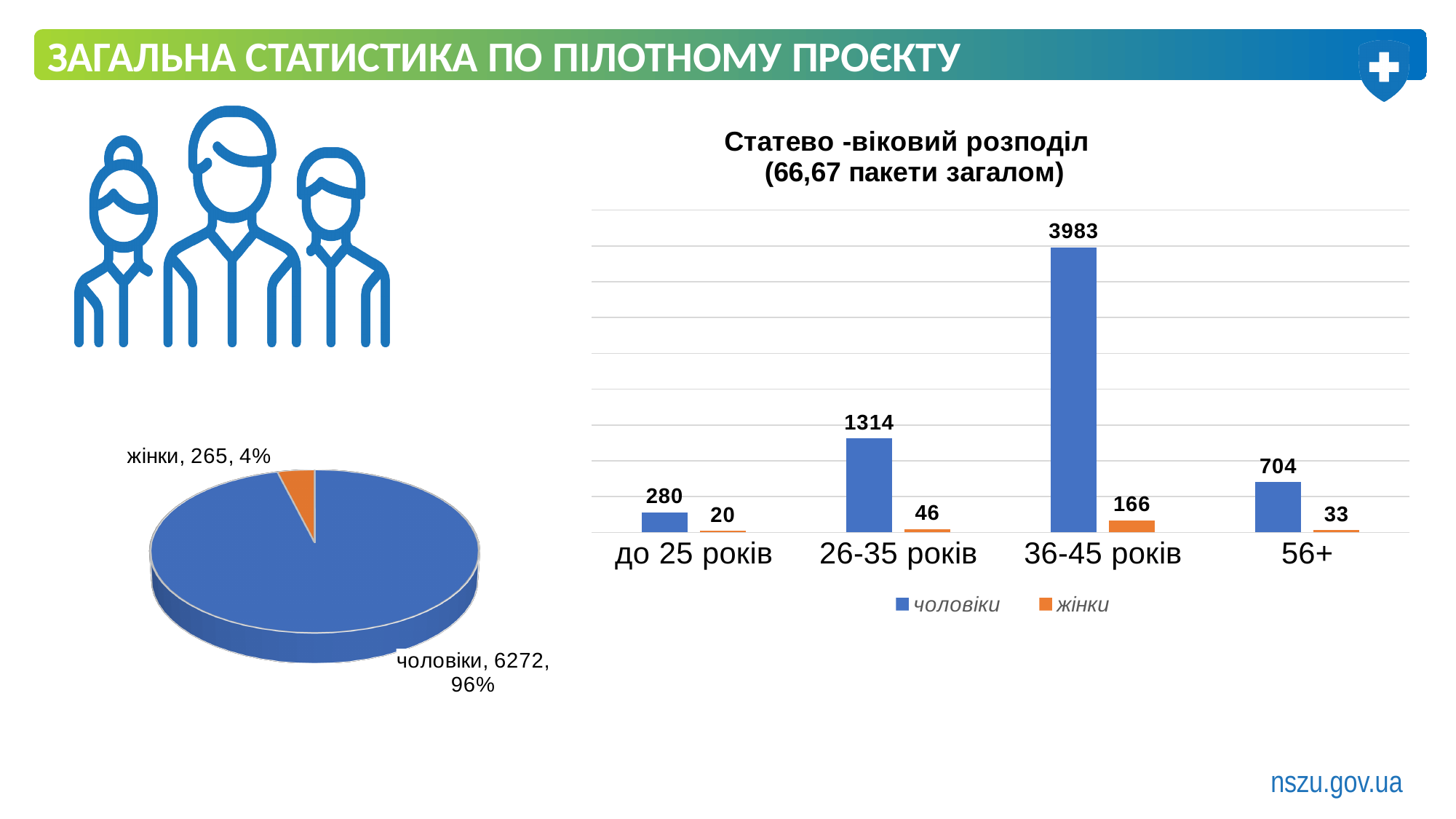
In the bar chart 'Статево -віковий розподіл', what is the value for чоловіки in the 36-45 років category? 3983 In the pie chart on the bottom left, what share of the pie does the чоловіки slice represent? 96% In the bar chart 'Статево -віковий розподіл', what is the value for чоловіки in the 56+ category? 704 In the bar chart 'Статево -віковий розподіл', which age category has the lowest value for жінки? до 25 років How many age categories are shown on the x axis of the bar chart 'Статево -віковий розподіл'? 4 How many series does the legend of the bar chart 'Статево -віковий розподіл' list? 2 In the bar chart 'Статево -віковий розподіл', what is the value for жінки in the 26-35 років category? 46 What kind of chart is the chart on the bottom left of the slide? Pie chart In the bar chart 'Статево -віковий розподіл', what is the difference between the чоловіки values for 26-35 років and 56+? 610 In the bar chart 'Статево -віковий розподіл', which is larger: the жінки value for 36-45 років or the жінки value for 56+? 36-45 років In the bar chart 'Статево -віковий розподіл', which age category has the highest value for чоловіки? 36-45 років In the pie chart on the bottom left, what is the value shown for жінки? 265